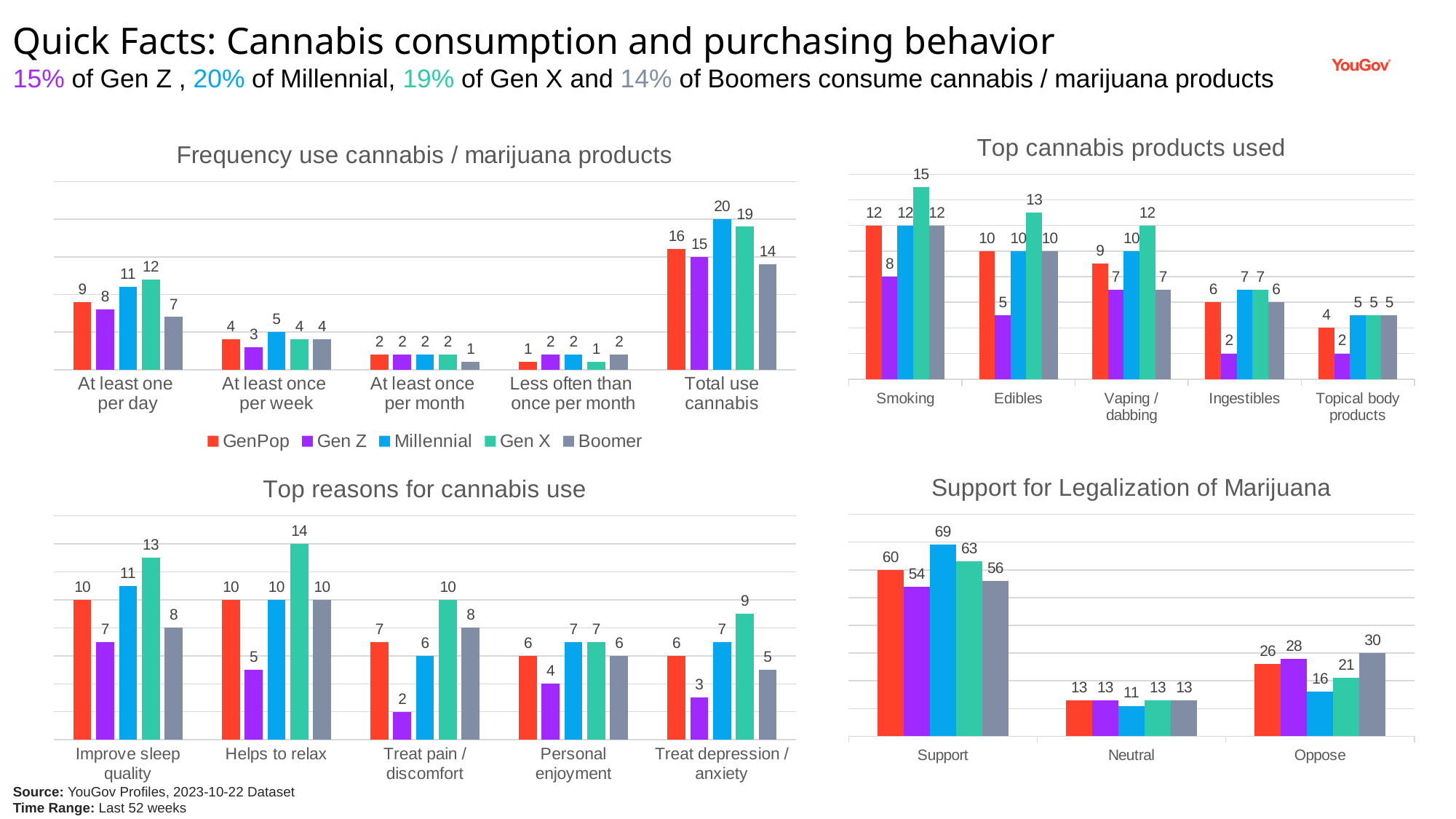
How many series does the legend on the slide list? 5 In the 'Top cannabis products used' chart, what is the difference between the Gen X and Gen Z values for Edibles? 8 In the 'Support for Legalization of Marijuana' chart, which series has the highest value for Oppose? Boomer In the 'Top cannabis products used' chart, what is the Gen X value for Smoking? 15 In the 'Frequency use cannabis / marijuana products' chart, what is the Millennial value for 'Total use cannabis'? 20 In the 'Top reasons for cannabis use' chart, which is larger for 'Treat pain / discomfort': the Boomer value or the Millennial value? Boomer In the 'Frequency use cannabis / marijuana products' chart, how many categories are shown on the x axis? 5 In the 'Top reasons for cannabis use' chart, what is the Gen X value for 'Helps to relax'? 14 In the 'Support for Legalization of Marijuana' chart, what is the Millennial value for Support? 69 In the 'Top cannabis products used' chart, which series has the highest value for 'Vaping / dabbing'? Gen X In the 'Frequency use cannabis / marijuana products' chart, which series has the lowest value for 'At least one per day'? Boomer In the 'Support for Legalization of Marijuana' chart, what is the difference between the GenPop Support value and the GenPop Oppose value? 34